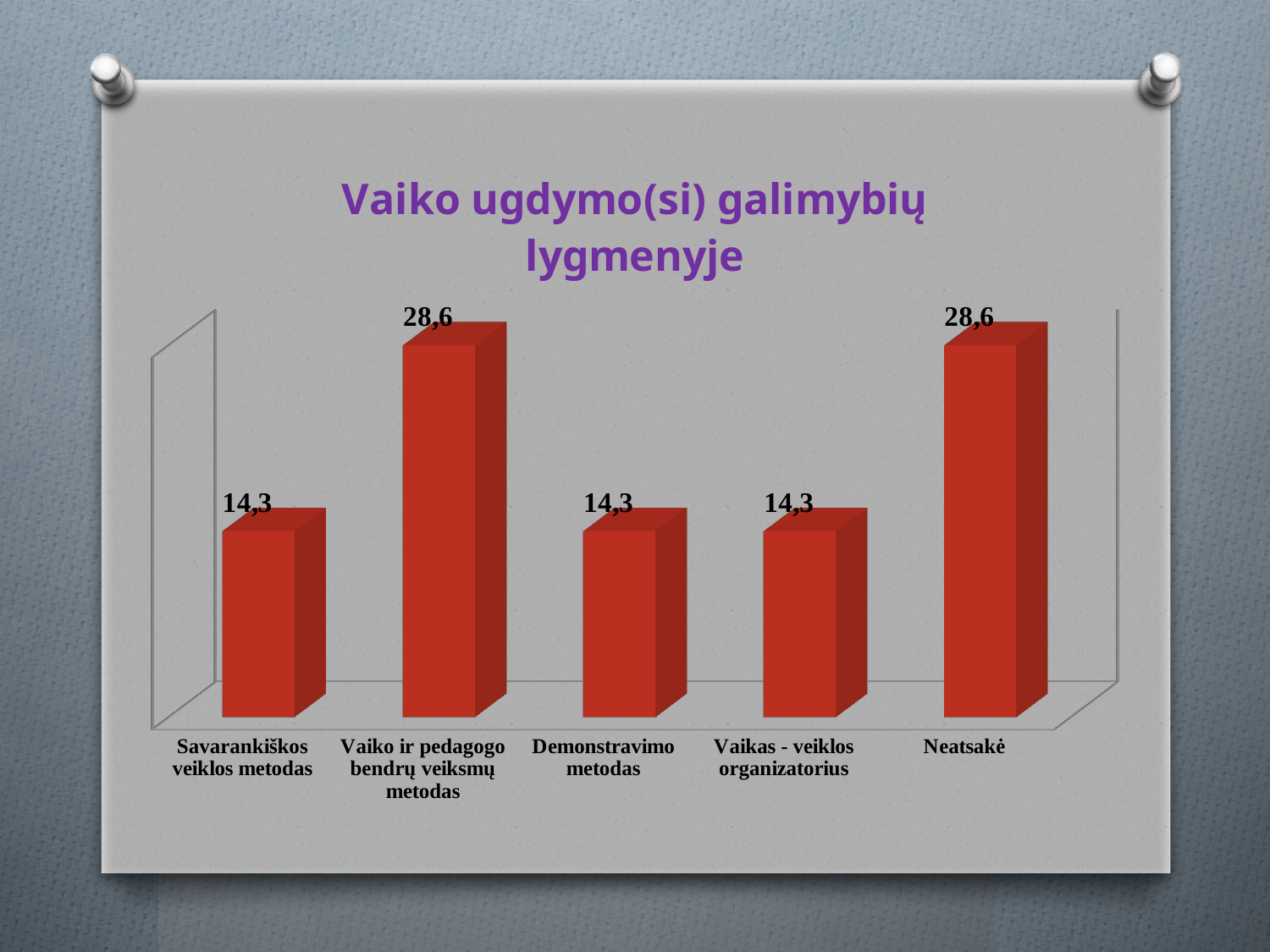
What is the difference between the value for Neatsakė and the value for Demonstravimo metodas? 14,3 What is the value for Savarankiškos veiklos metodas? 14,3 What is the value for Neatsakė? 28,6 Which is larger: the value for Vaiko ir pedagogo bendrų veiksmų metodas or the value for Savarankiškos veiklos metodas? Vaiko ir pedagogo bendrų veiksmų metodas What colour are the bars in the chart? Red Which two categories share the highest value on the chart? Vaiko ir pedagogo bendrų veiksmų metodas and Neatsakė What is the value for Vaiko ir pedagogo bendrų veiksmų metodas? 28,6 What is the value for Vaikas - veiklos organizatorius? 14,3 What is the value for Demonstravimo metodas? 14,3 What is the title of the chart? Vaiko ugdymo(si) galimybių lygmenyje How many categories are shown on the chart? 5 What kind of chart is shown on the slide? Bar chart